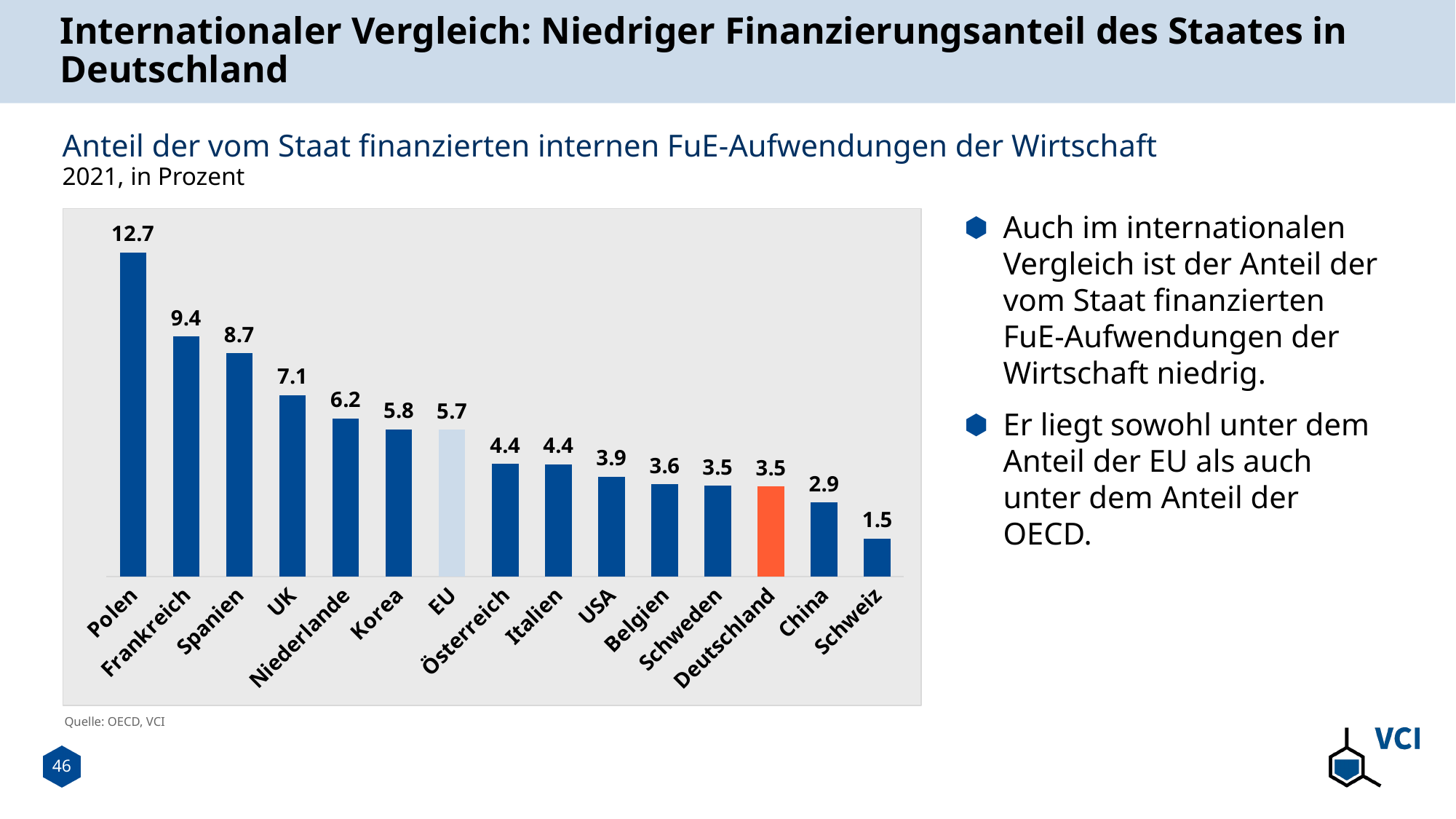
What is the difference between the values for EU and Deutschland? 2.2 What is the value for Deutschland? 3.5 Which bar is highlighted in orange? Deutschland What is the value for EU? 5.7 How many countries or regions are shown in the chart? 15 Do the values rise or fall from left to right along the x axis? Fall What kind of chart is shown on the slide? Bar chart What is the difference between the values for Frankreich and Spanien? 0.7 Which is larger, the value for UK or the value for Niederlande? UK Which country has the highest value? Polen What is the value for Polen? 12.7 Which country has the lowest value? Schweiz